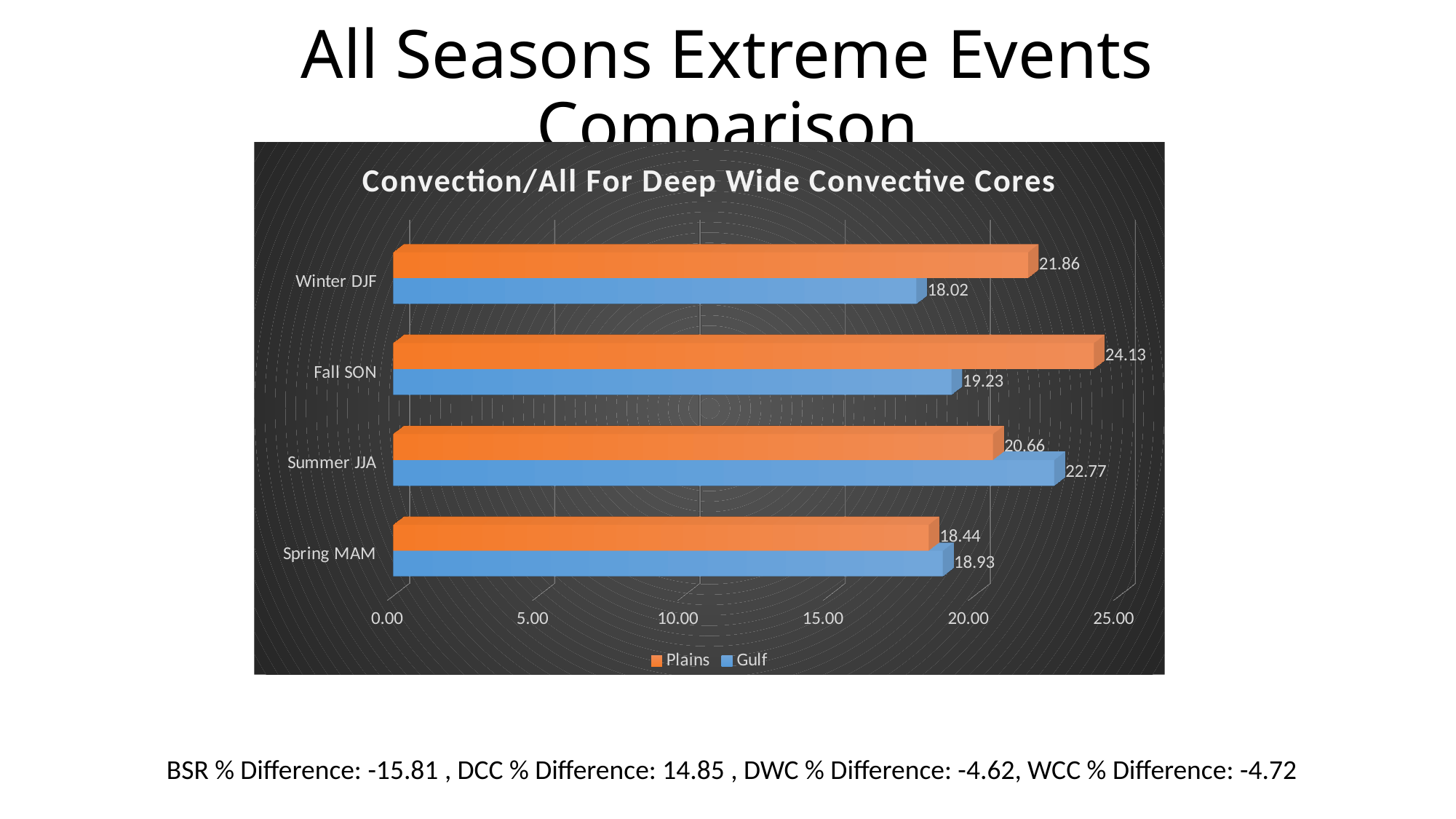
What is the difference between the Plains and Gulf values for Fall SON? 4.90 How many series does the legend list? 2 Which is larger for Summer JJA, the Plains value or the Gulf value? Gulf Which season has the lowest Gulf value? Winter DJF What is the Gulf value for Summer JJA? 22.77 What is the Gulf value for Winter DJF? 18.02 How many seasons are shown on the chart? 4 What is the Plains value for Spring MAM? 18.44 What is the title of the chart? Convection/All For Deep Wide Convective Cores Which season has the highest Plains value? Fall SON What is the Plains value for Fall SON? 24.13 What kind of chart is shown? Bar chart